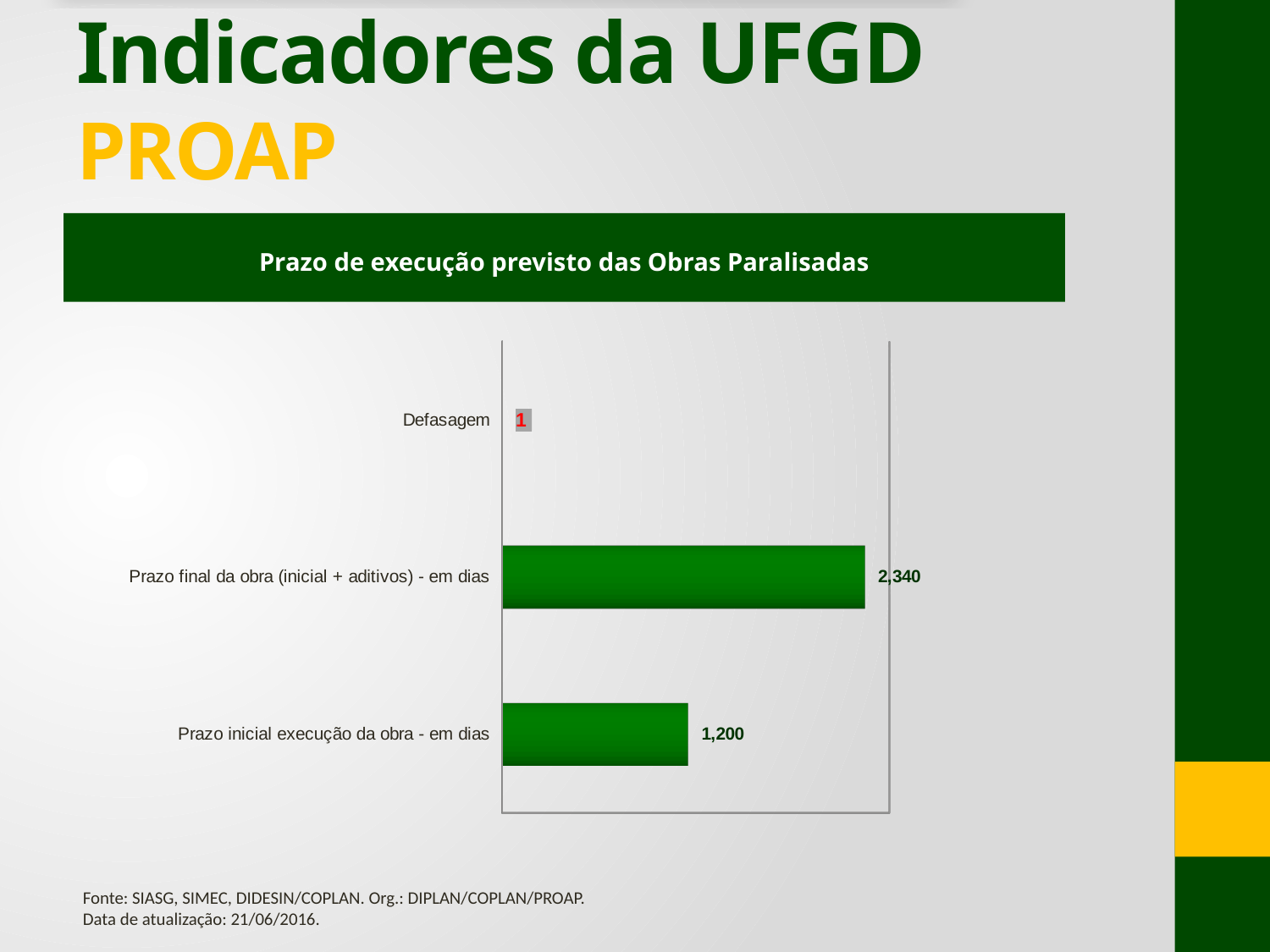
What is the value shown for "Defasagem"? 1 Which category has the highest value? Prazo final da obra (inicial + aditivos) - em dias Which is larger: the value for "Prazo inicial execução da obra - em dias" or the value for "Prazo final da obra (inicial + aditivos) - em dias"? Prazo final da obra (inicial + aditivos) - em dias What is the difference between the value for "Prazo final da obra (inicial + aditivos) - em dias" and the value for "Prazo inicial execução da obra - em dias"? 1,140 How many categories are shown in the chart? 3 What colour is the data label for "Defasagem"? Red What kind of chart is shown on the slide? Bar chart What is the title of the chart? Prazo de execução previsto das Obras Paralisadas What is the value for "Prazo final da obra (inicial + aditivos) - em dias"? 2,340 What is the value for "Prazo inicial execução da obra - em dias"? 1,200 Which category has the lowest value? Defasagem